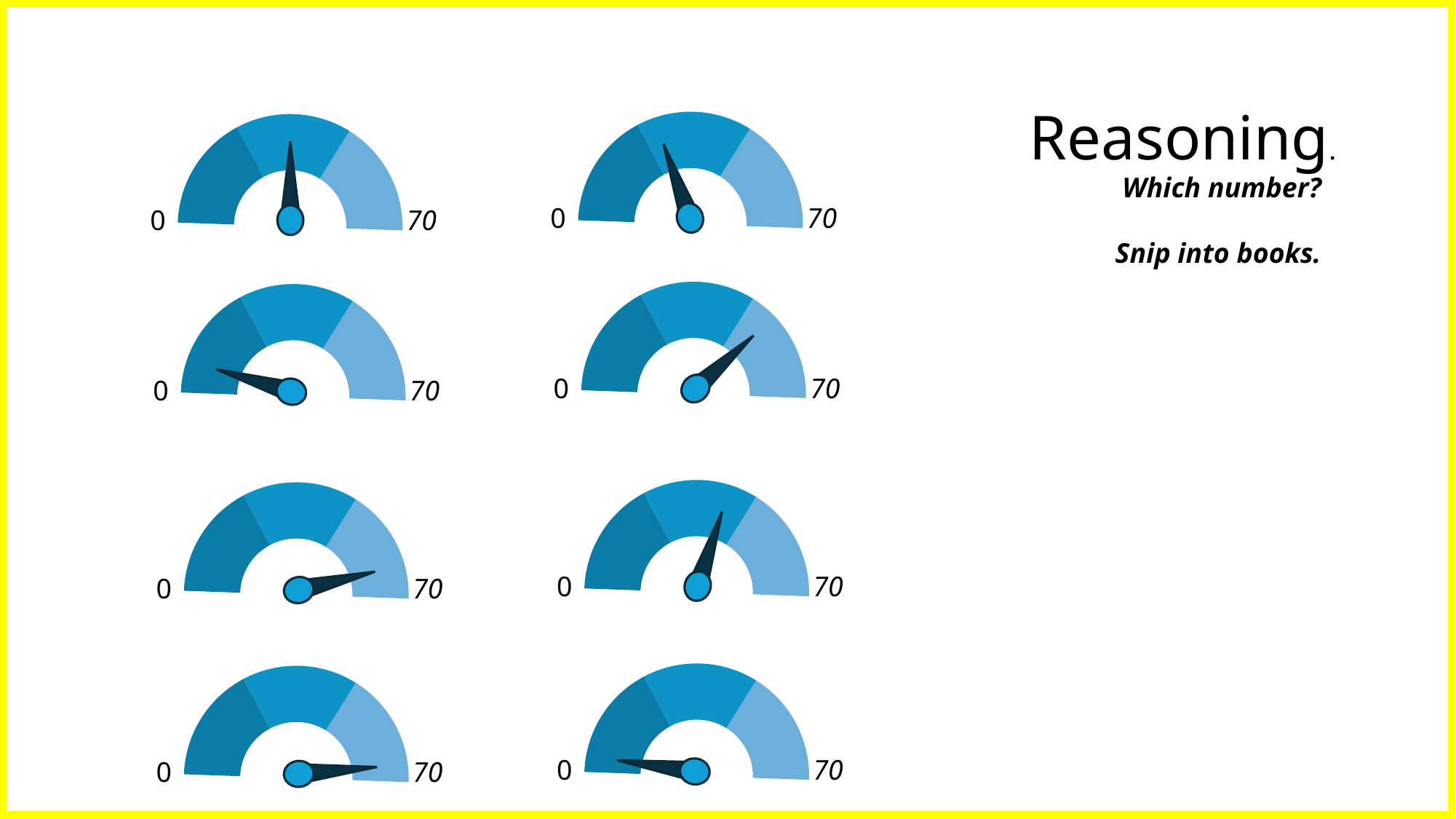
What are the minimum and maximum labels shown on each gauge? 0 and 70 How many gauge charts are on the slide? 8 In the third row, which gauge shows the larger value: the left gauge or the right gauge? the left gauge Which gauge shows the larger value: the left gauge in the second row or the left gauge in the third row? the left gauge in the third row Which gauge shows the larger value: the top-left gauge or the bottom-right gauge? the top-left gauge What kind of chart is shown on the left side of the slide? gauge chart What is the title text at the top right of the slide? Reasoning.